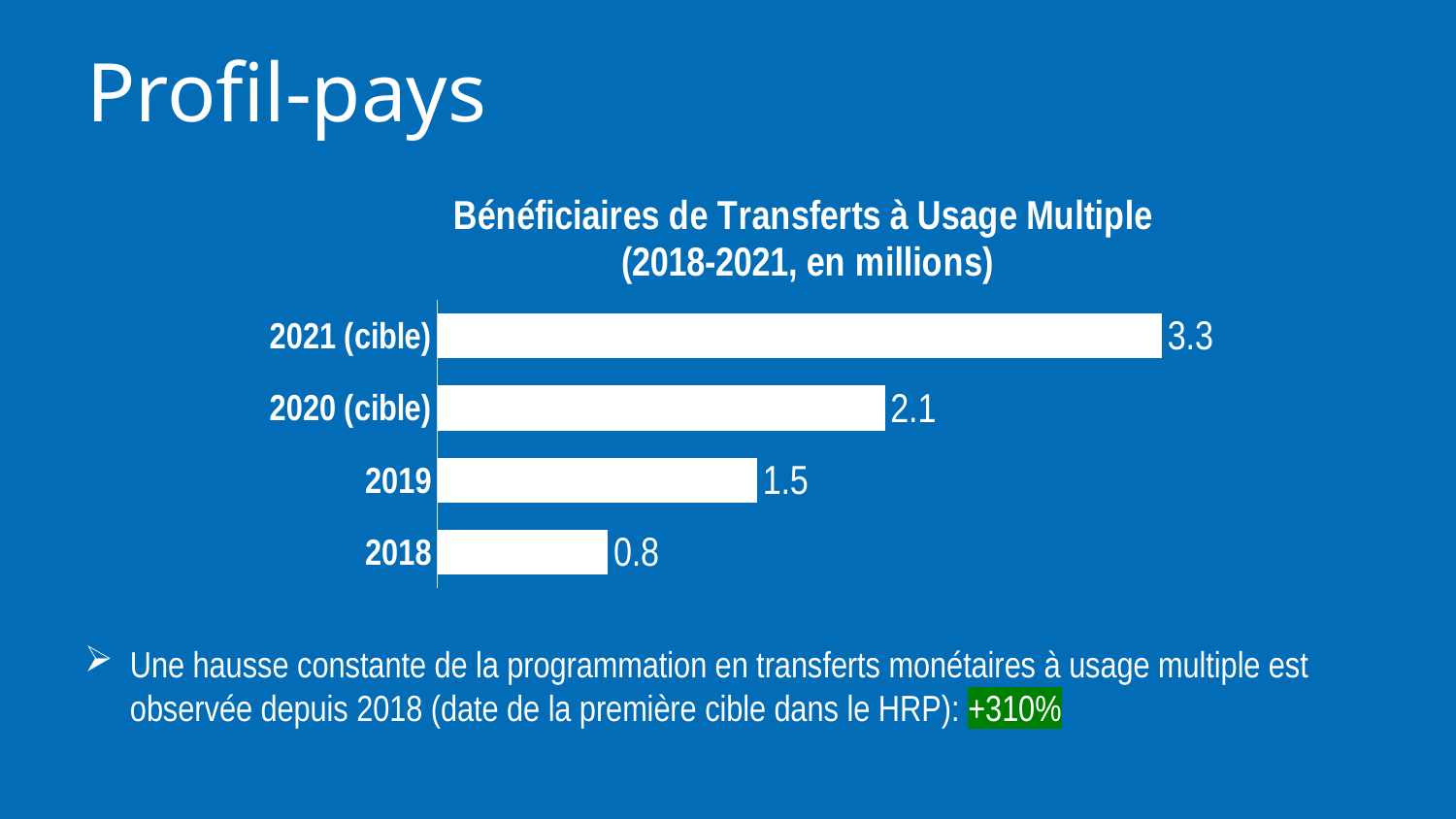
What is the value for 2018? 0.8 What is the difference between the values for 2020 (cible) and 2019? 0.6 Which is larger, the value for 2019 or the value for 2020 (cible)? 2020 (cible) What is the difference between the values for 2021 (cible) and 2018? 2.5 What is the value for 2021 (cible)? 3.3 What is the value for 2020 (cible)? 2.1 What is the title of the chart? Bénéficiaires de Transferts à Usage Multiple (2018-2021, en millions) What kind of chart is shown on the slide? Bar chart Which category has the lowest value? 2018 What is the value for 2019? 1.5 How many categories are shown in the chart? 4 Which category has the highest value? 2021 (cible)